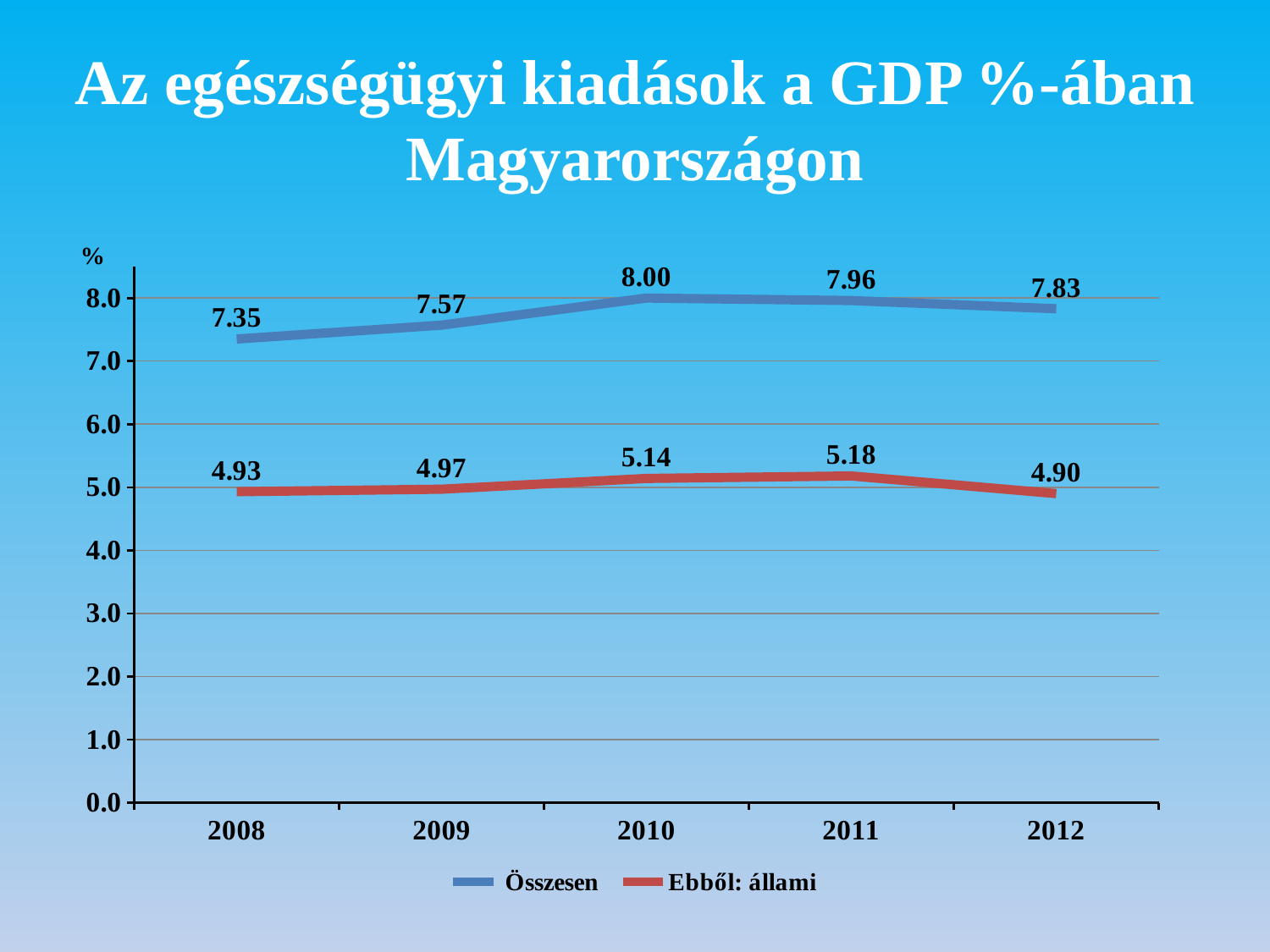
Does the Ebből: állami series rise or fall from 2011 to 2012? Fall In which year is the Összesen series lowest? 2008 Which is larger: the Összesen value in 2009 or the Összesen value in 2012? 2012 What is the value of the Összesen series in 2010? 8.00 What is the value of the Ebből: állami series in 2012? 4.90 What is the value of the Összesen series in 2008? 7.35 In which year is the Ebből: állami series highest? 2011 What colour is the line for the Ebből: állami series? Red How many series does the legend list? 2 What kind of chart is shown on the slide? Line chart What is the difference between the Összesen and Ebből: állami values in 2010? 2.86 How many years are shown on the x axis? 5